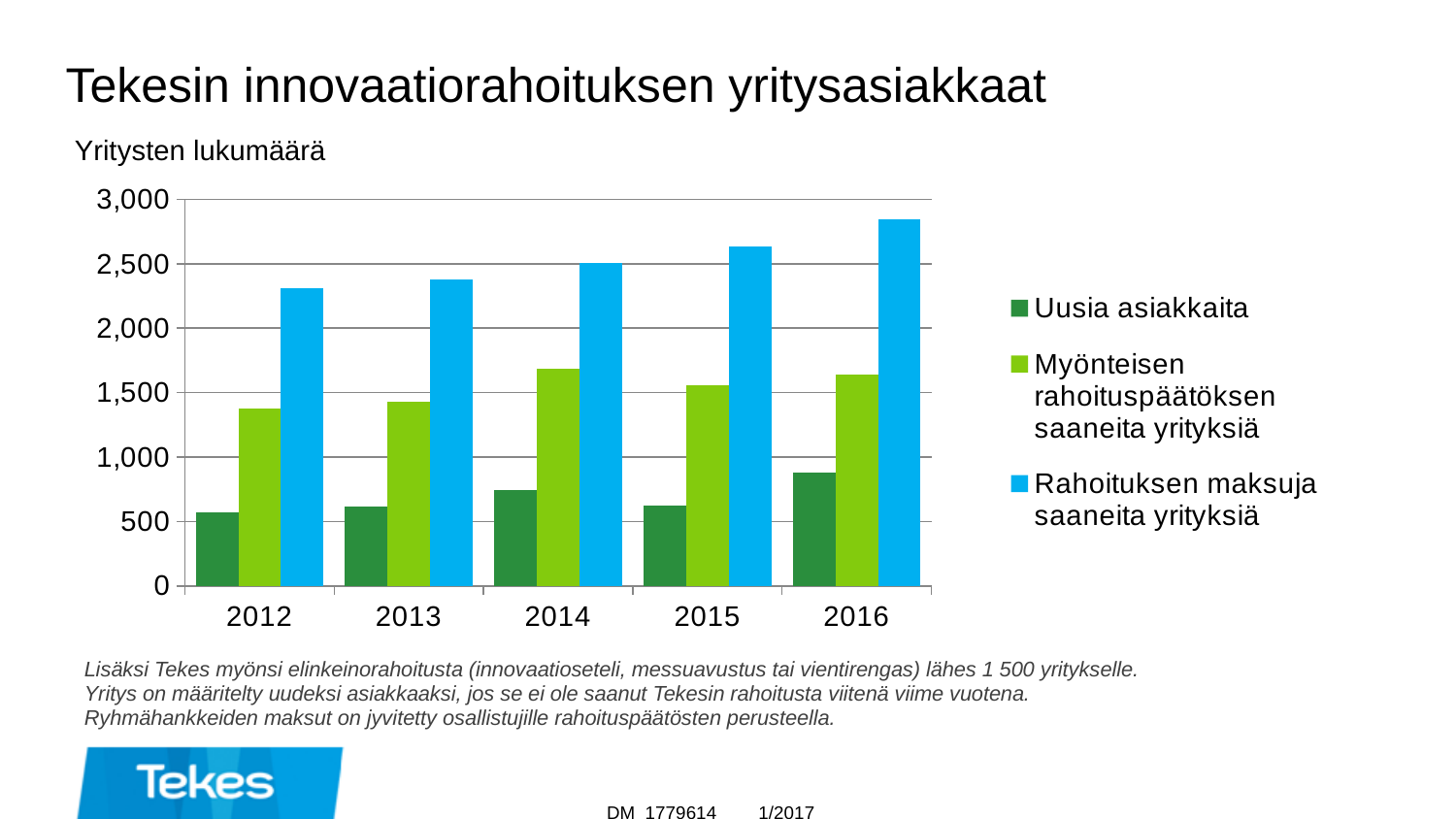
Does Rahoituksen maksuja saaneita yrityksiä rise or fall from 2012 to 2016? rise Is the value for Rahoituksen maksuja saaneita yrityksiä in 2012 greater or less than 2,500? less In which year is Uusia asiakkaita highest? 2016 Is the value for Rahoituksen maksuja saaneita yrityksiä in 2016 greater or less than 2,500? greater Is the value for Myönteisen rahoituspäätöksen saaneita yrityksiä in 2014 greater or less than 1,500? greater In which year is Rahoituksen maksuja saaneita yrityksiä highest? 2016 Which is larger for Uusia asiakkaita: the value in 2014 or in 2015? 2014 How many years are shown on the x axis? 5 How many series does the legend list? 3 What kind of chart is shown on the slide? bar chart